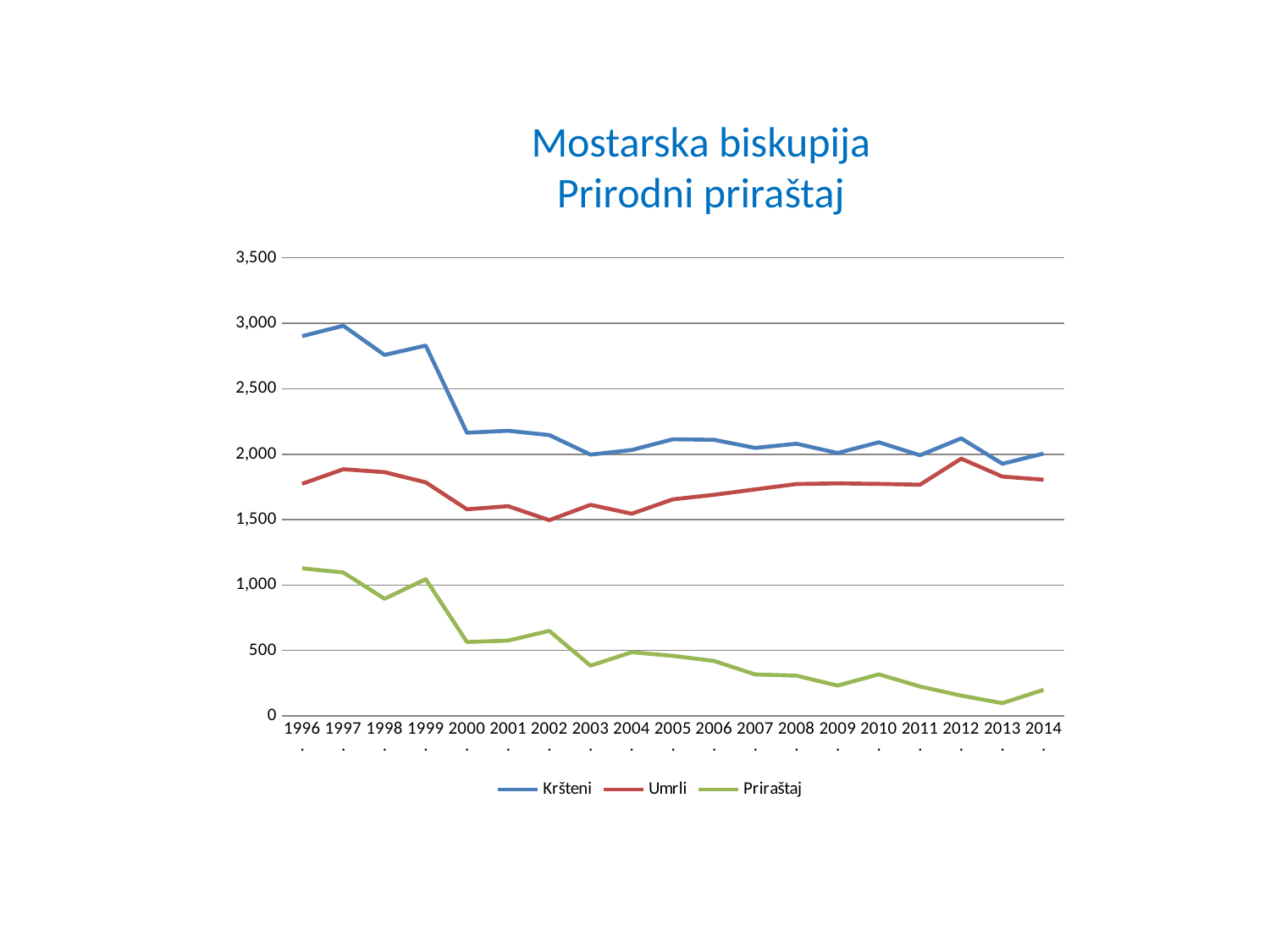
In which year is the Umrli series at its highest? 2012 Does the Priraštaj series generally rise or fall from 1996 to 2014? fall Is the value for Priraštaj in 2013 greater or less than 500? less What colour is the line for Umrli? red What kind of chart is shown on the slide? line chart In which year is the Priraštaj series at its lowest? 2013 Which is larger in 2000, Kršteni or Umrli? Kršteni How many series does the legend list? 3 Is the value for Kršteni in 1996 greater or less than 2,500? greater How many years are plotted along the x axis? 19 Is the value for Kršteni in 2000 greater or less than 2,500? less